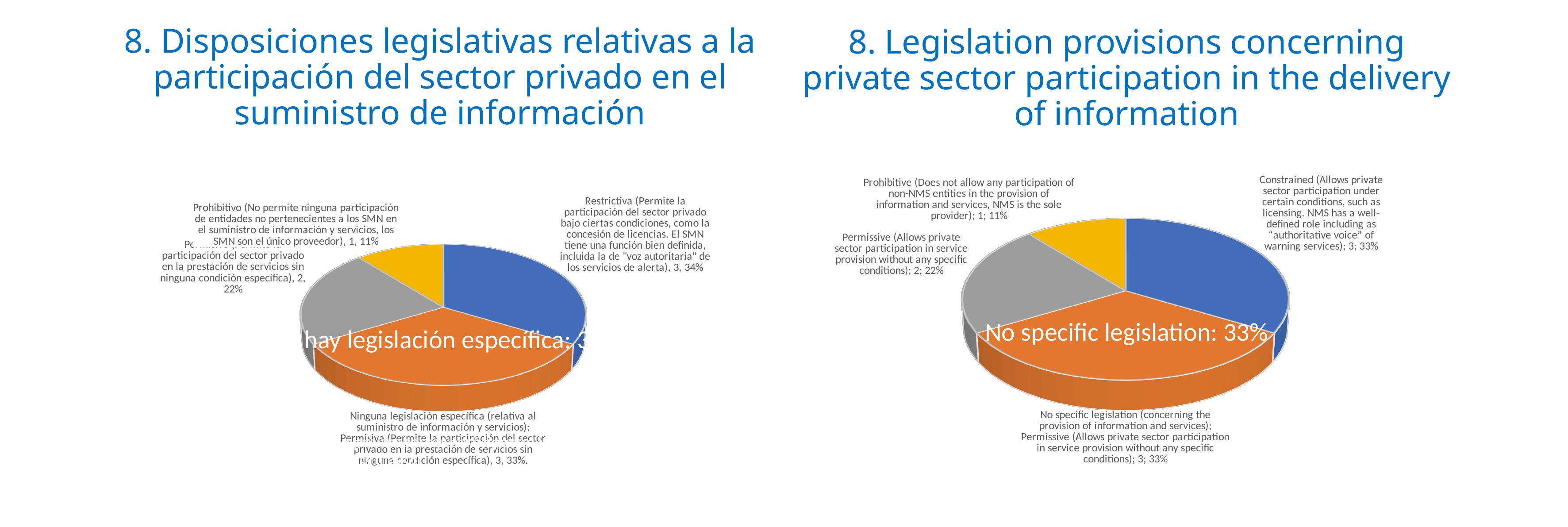
In the left-hand (Spanish) pie chart, what percentage is shown for the Restrictiva category? 34% In the right-hand (English) pie chart, what count and percentage are shown for the Prohibitive category? 1; 11% In the right-hand (English) pie chart, what percentage is shown for the Constrained category? 33% In the right-hand (English) pie chart, what colour is the No specific legislation slice? orange In the right-hand (English) pie chart, what count is shown for the No specific legislation category? 3 In the right-hand (English) pie chart, which category has the smallest share? Prohibitive In the right-hand (English) pie chart, how many categories (slices) are there? 4 In the left-hand (Spanish) pie chart, what percentage is shown for the Prohibitivo category? 11% In the right-hand (English) pie chart, what is the difference in percentage points between the Permissive share and the Prohibitive share? 11 In the right-hand (English) pie chart, which is larger, the Permissive share or the Prohibitive share? Permissive In the right-hand (English) pie chart, what percentage is shown for the Permissive category? 22% What kind of chart is shown on the right side of the slide under the title "8. Legislation provisions concerning private sector participation in the delivery of information"? pie chart